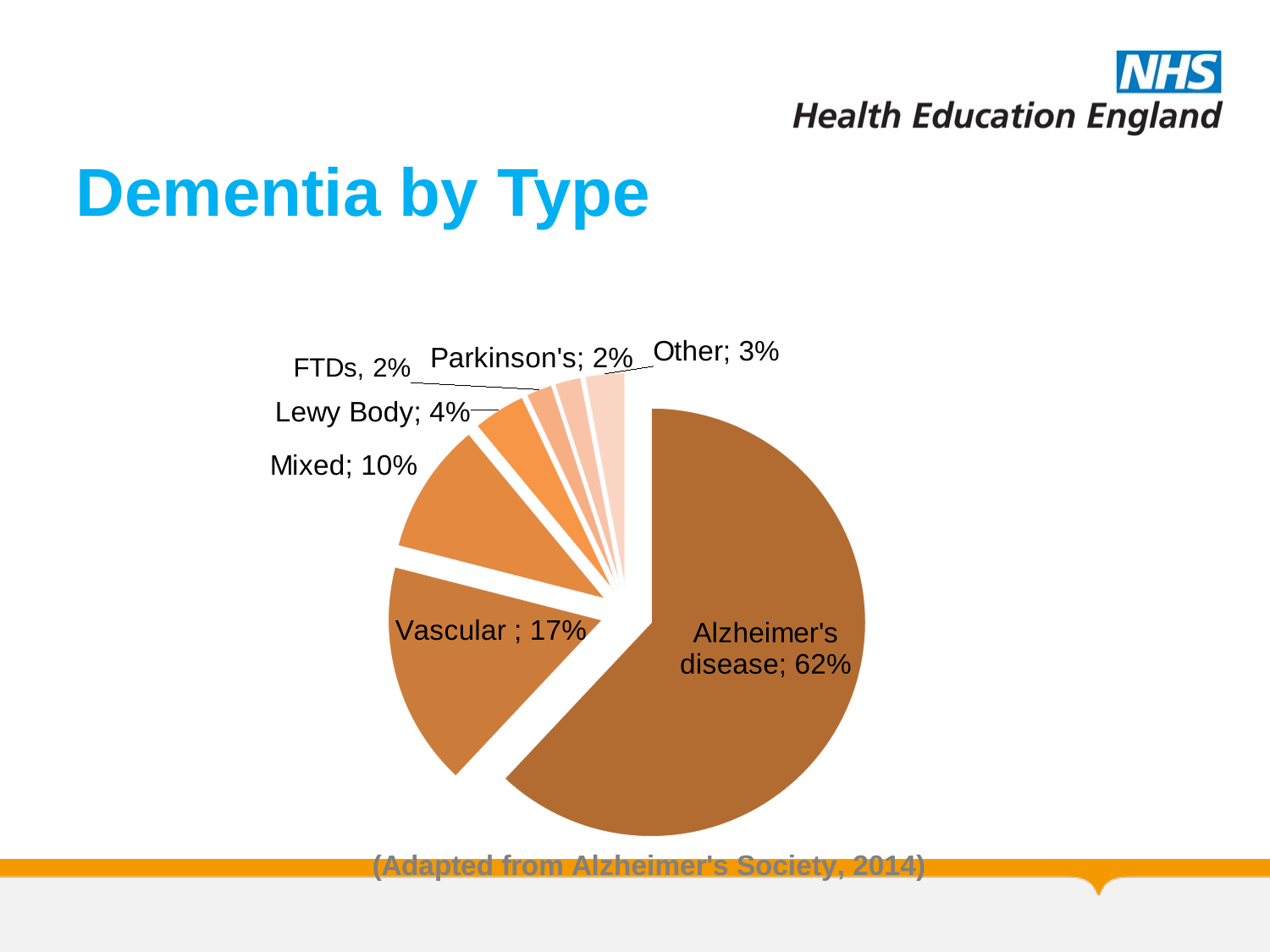
What type of chart is shown on the slide? Pie chart Which dementia type has the largest share of the pie? Alzheimer's disease What is the difference between the Alzheimer's disease share and the Vascular share? 45% What is the combined share of FTDs and Parkinson's? 4% What percentage of dementia is Other? 3% What percentage of dementia is Lewy Body? 4% How many slices does the pie chart have? 7 What percentage of dementia is Mixed? 10% What percentage of dementia is Vascular? 17% Which is larger, the share for Vascular or the share for Mixed? Vascular What percentage of dementia is Alzheimer's disease? 62% What is the title of the slide containing the chart? Dementia by Type